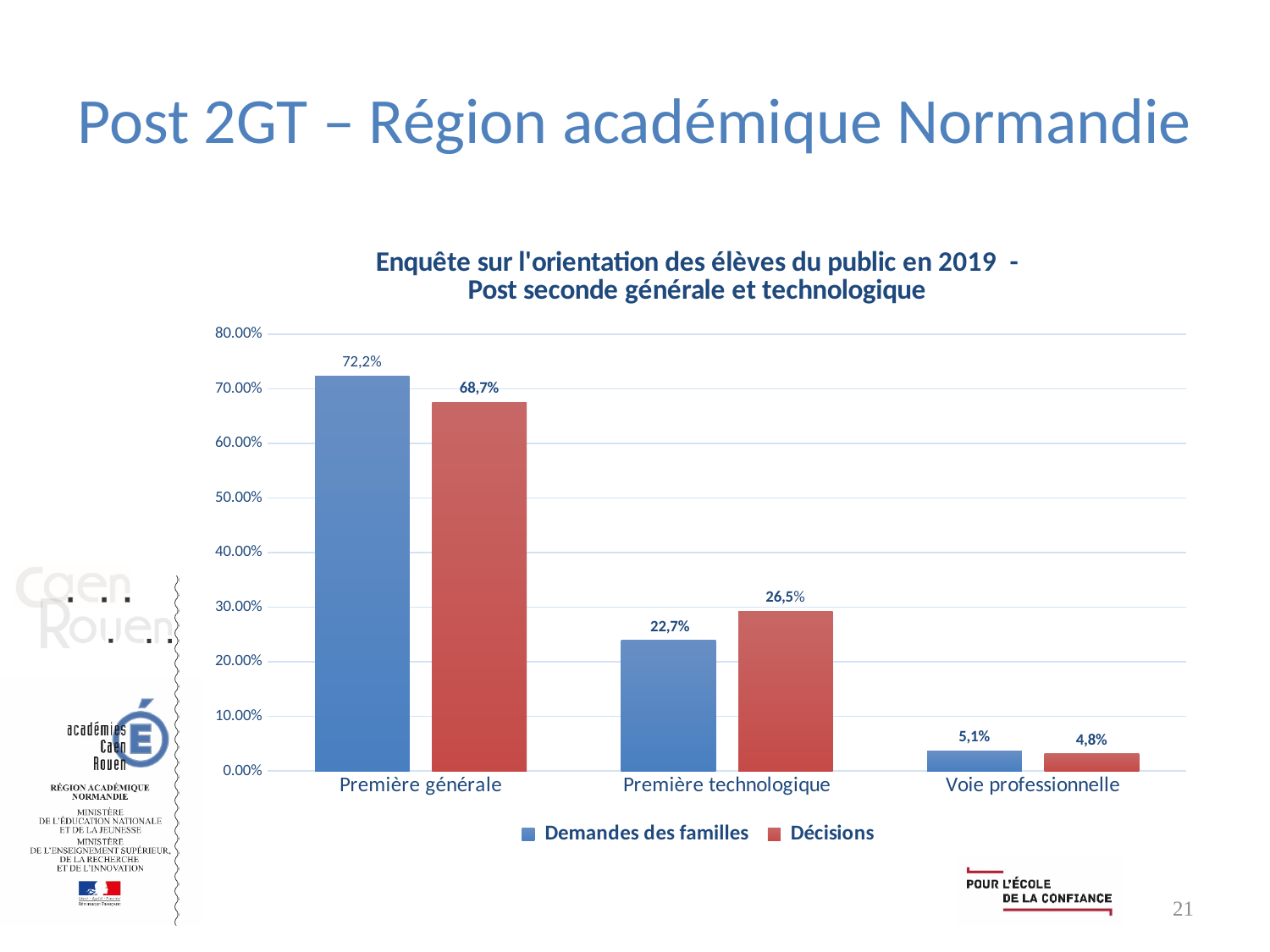
Which category has the highest value for Décisions? Première générale What is the value of Demandes des familles for Première générale? 72,2% How many categories are shown on the x axis? 3 Which category has the lowest value for Demandes des familles? Voie professionnelle What is the value of Décisions for Voie professionnelle? 4,8% What is the difference between Demandes des familles and Décisions for Première générale? 3,5 points How many series does the legend list? 2 For Première technologique, which is larger: Demandes des familles or Décisions? Décisions What is the value of Demandes des familles for Voie professionnelle? 5,1% What is the value of Décisions for Première technologique? 26,5% What kind of chart is shown on the slide? Bar chart Is the value of Décisions for Première générale greater or less than 60.00%? greater